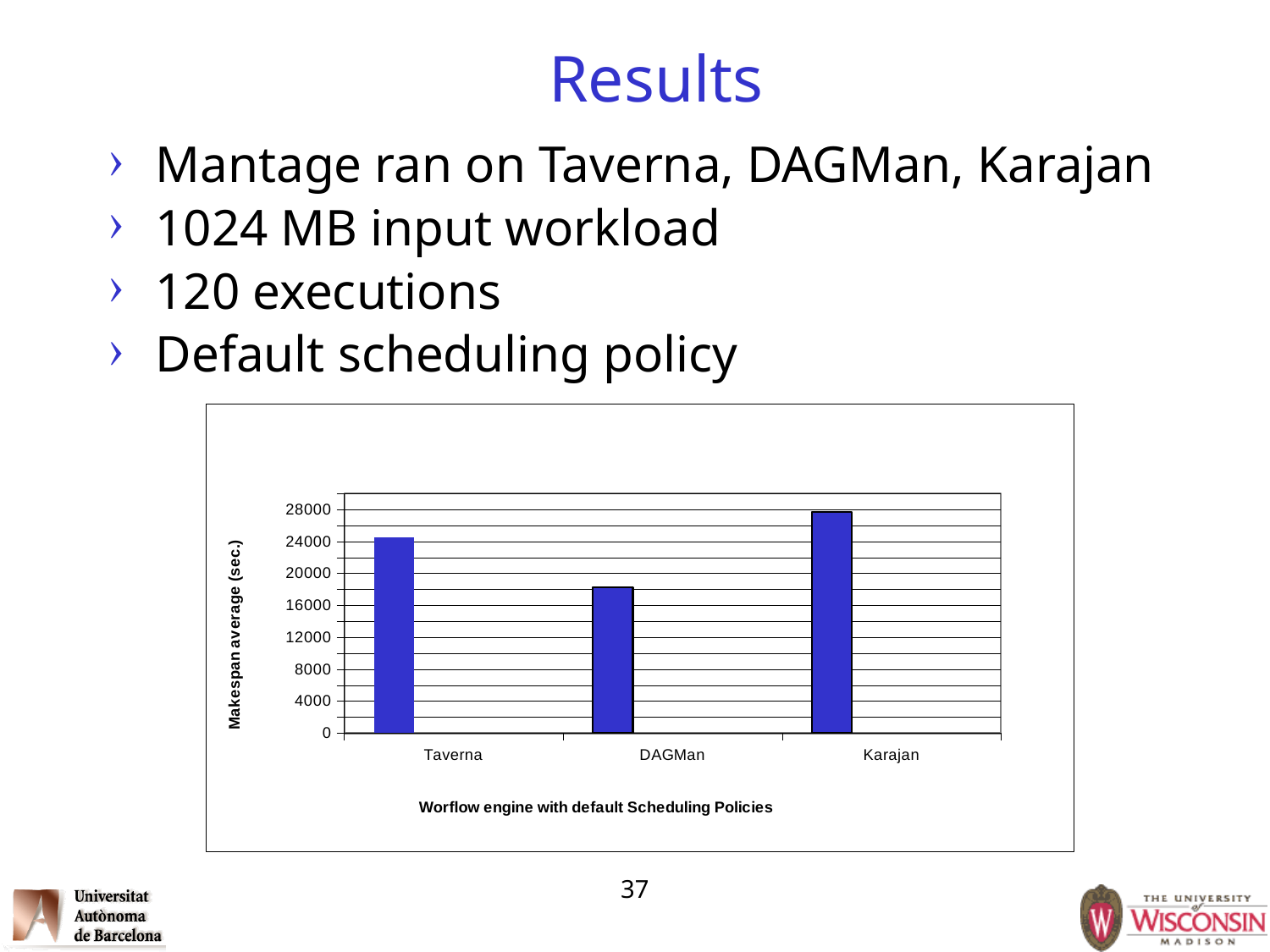
Which workflow engine has the lowest makespan average? DAGMan What kind of chart is shown on the slide? bar chart How many workflow engines are plotted on the x axis? 3 Which workflow engine has the highest makespan average? Karajan What is the label of the y axis? Makespan average (sec.) What is the label of the x axis? Worflow engine with default Scheduling Policies Which has a larger makespan average, DAGMan or Karajan? Karajan Is the makespan average for Taverna greater or less than 28000? less Is the makespan average for DAGMan greater or less than 20000? less Is the makespan average for Taverna greater or less than 20000? greater Which has a larger makespan average, Taverna or DAGMan? Taverna